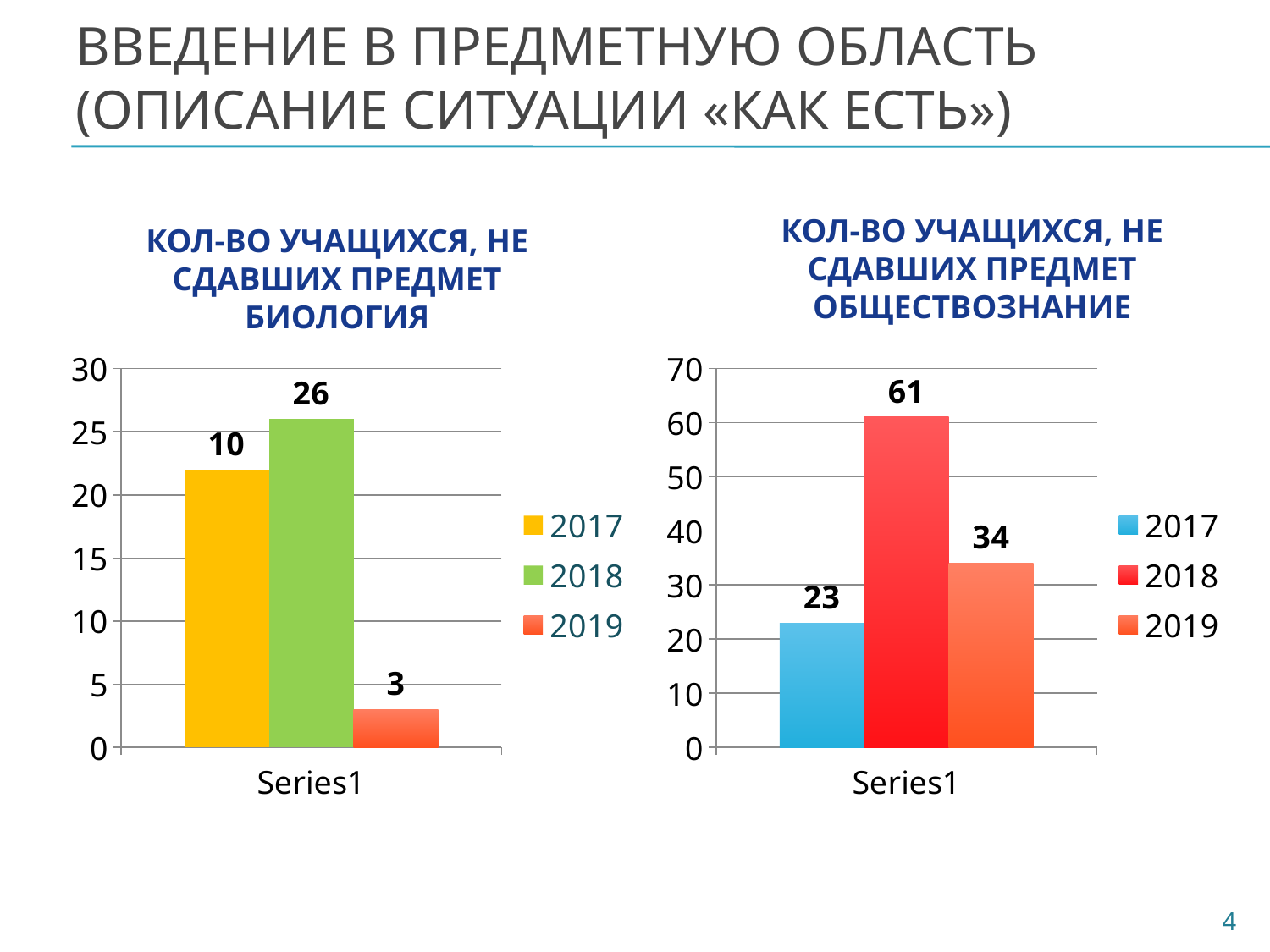
In the chart titled «Кол-во учащихся, не сдавших предмет Обществознание», which is larger, the value for 2017 or the value for 2019? 2019 How many series does the legend of the right-hand chart list? 3 In the chart titled «Кол-во учащихся, не сдавших предмет Биология», what is the value for 2018? 26 In the chart titled «Кол-во учащихся, не сдавших предмет Биология», which year has the highest value? 2018 In the chart titled «Кол-во учащихся, не сдавших предмет Обществознание», what is the value for 2019? 34 In the chart titled «Кол-во учащихся, не сдавших предмет Биология», which year has the lowest value? 2019 What kind of chart is the left-hand chart on the slide? bar chart In the chart titled «Кол-во учащихся, не сдавших предмет Обществознание», which year has the highest value? 2018 In the chart titled «Кол-во учащихся, не сдавших предмет Обществознание», what is the value for 2018? 61 In the chart titled «Кол-во учащихся, не сдавших предмет Обществознание», what is the value for 2017? 23 In the chart titled «Кол-во учащихся, не сдавших предмет Биология», what is the value for 2019? 3 In the chart titled «Кол-во учащихся, не сдавших предмет Обществознание», what is the difference between the values for 2018 and 2019? 27